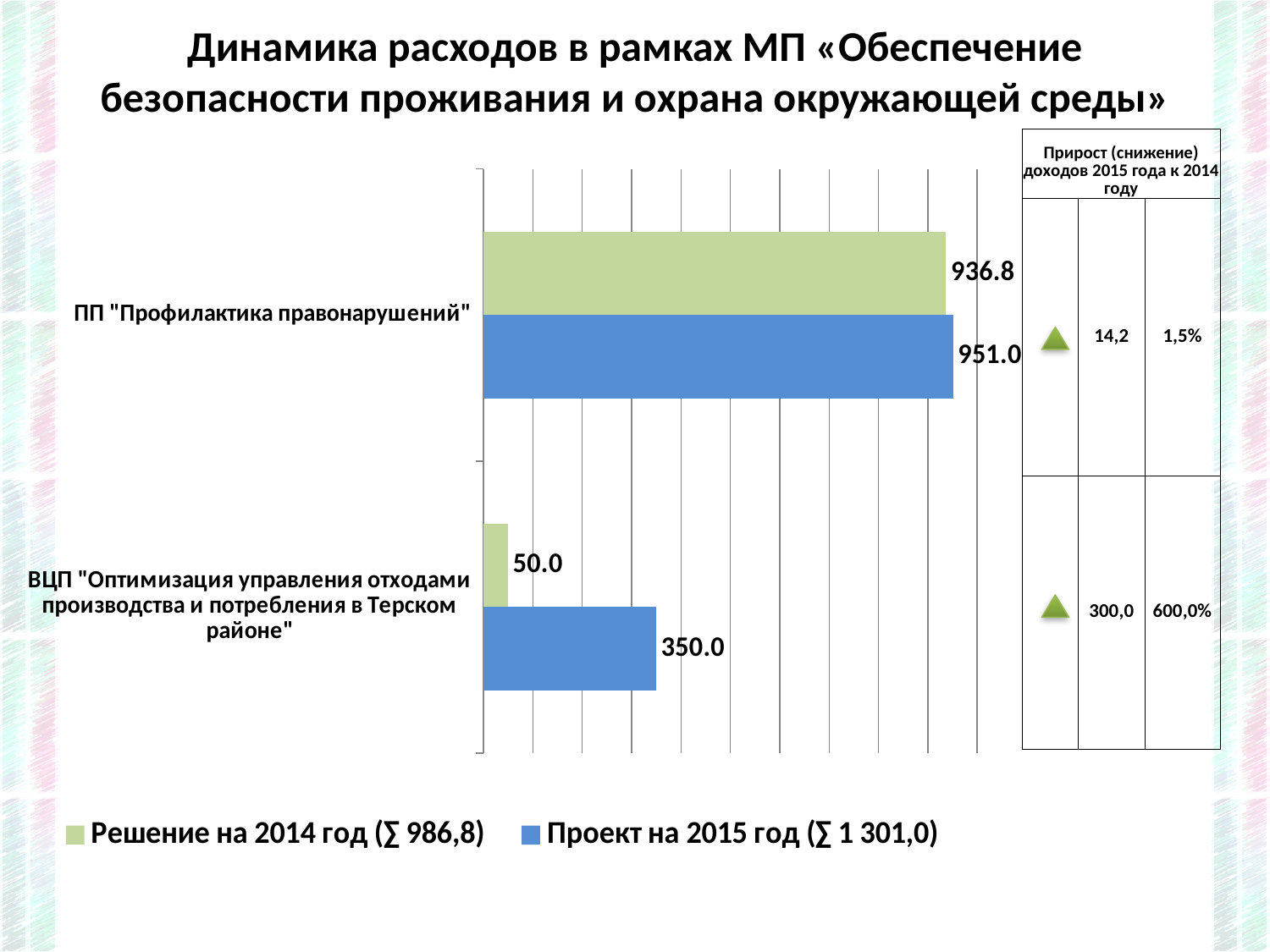
What is the value for ВЦП "Оптимизация управления отходами производства и потребления в Терском районе" in the series Решение на 2014 год? 50.0 Which category has the lowest value in the series Решение на 2014 год? ВЦП "Оптимизация управления отходами производства и потребления в Терском районе" What is the difference between the 2015 and 2014 values for ПП "Профилактика правонарушений"? 14.2 What is the value for ПП "Профилактика правонарушений" in the series Проект на 2015 год? 951.0 How many series does the legend list? 2 What is the difference between the 2015 and 2014 values for ВЦП "Оптимизация управления отходами производства и потребления в Терском районе"? 300.0 What kind of chart is shown on the slide? Bar chart Which category has the highest value in the series Проект на 2015 год? ПП "Профилактика правонарушений" How many categories are shown in the chart? 2 Which is larger for ВЦП "Оптимизация управления отходами производства и потребления в Терском районе": the Решение на 2014 год value or the Проект на 2015 год value? Проект на 2015 год What is the value for ПП "Профилактика правонарушений" in the series Решение на 2014 год? 936.8 What is the value for ВЦП "Оптимизация управления отходами производства и потребления в Терском районе" in the series Проект на 2015 год? 350.0